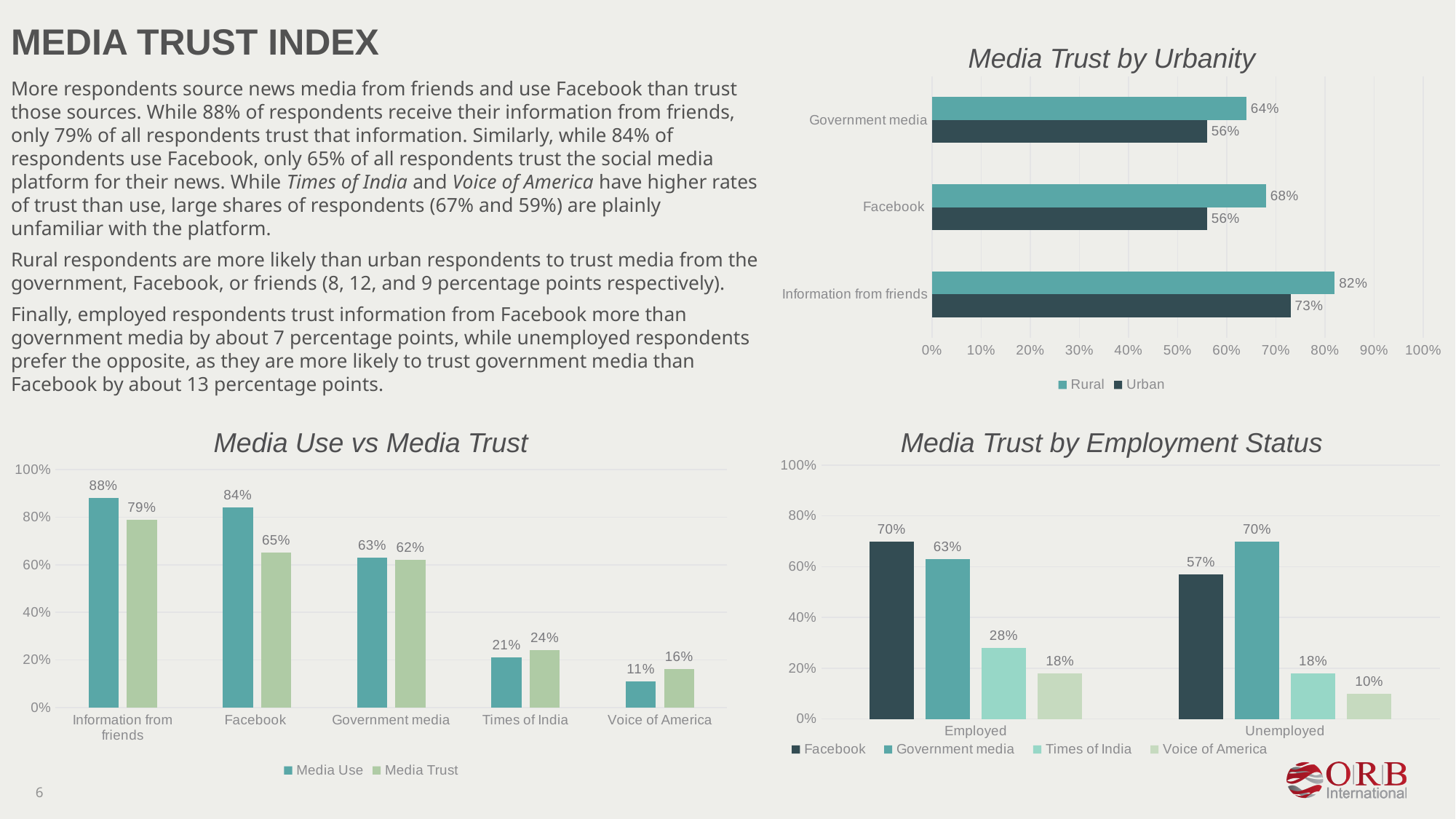
In the 'Media Trust by Urbanity' chart, what is the difference between the Rural and Urban values for Government media? 8 percentage points In the 'Media Use vs Media Trust' chart, what is the Media Use value for Voice of America? 11% In the 'Media Use vs Media Trust' chart, how many categories are shown on the x axis? 5 In the 'Media Trust by Employment Status' chart, what is the Government media value for Unemployed respondents? 70% In the 'Media Trust by Urbanity' chart, what is the Rural value for Facebook? 68% In the 'Media Trust by Employment Status' chart, which series has the lowest value for Unemployed respondents? Voice of America In the 'Media Trust by Urbanity' chart, what is the Urban value for Information from friends? 73% In the 'Media Use vs Media Trust' chart, what is the difference between Media Use and Media Trust for Facebook? 19 percentage points In the 'Media Trust by Urbanity' chart, how many series does the legend list? 2 In the 'Media Use vs Media Trust' chart, which category has the highest Media Trust value? Information from friends In the 'Media Trust by Employment Status' chart, is the Times of India value for Employed respondents larger or smaller than the Times of India value for Unemployed respondents? larger What kind of chart is 'Media Trust by Urbanity'? bar chart